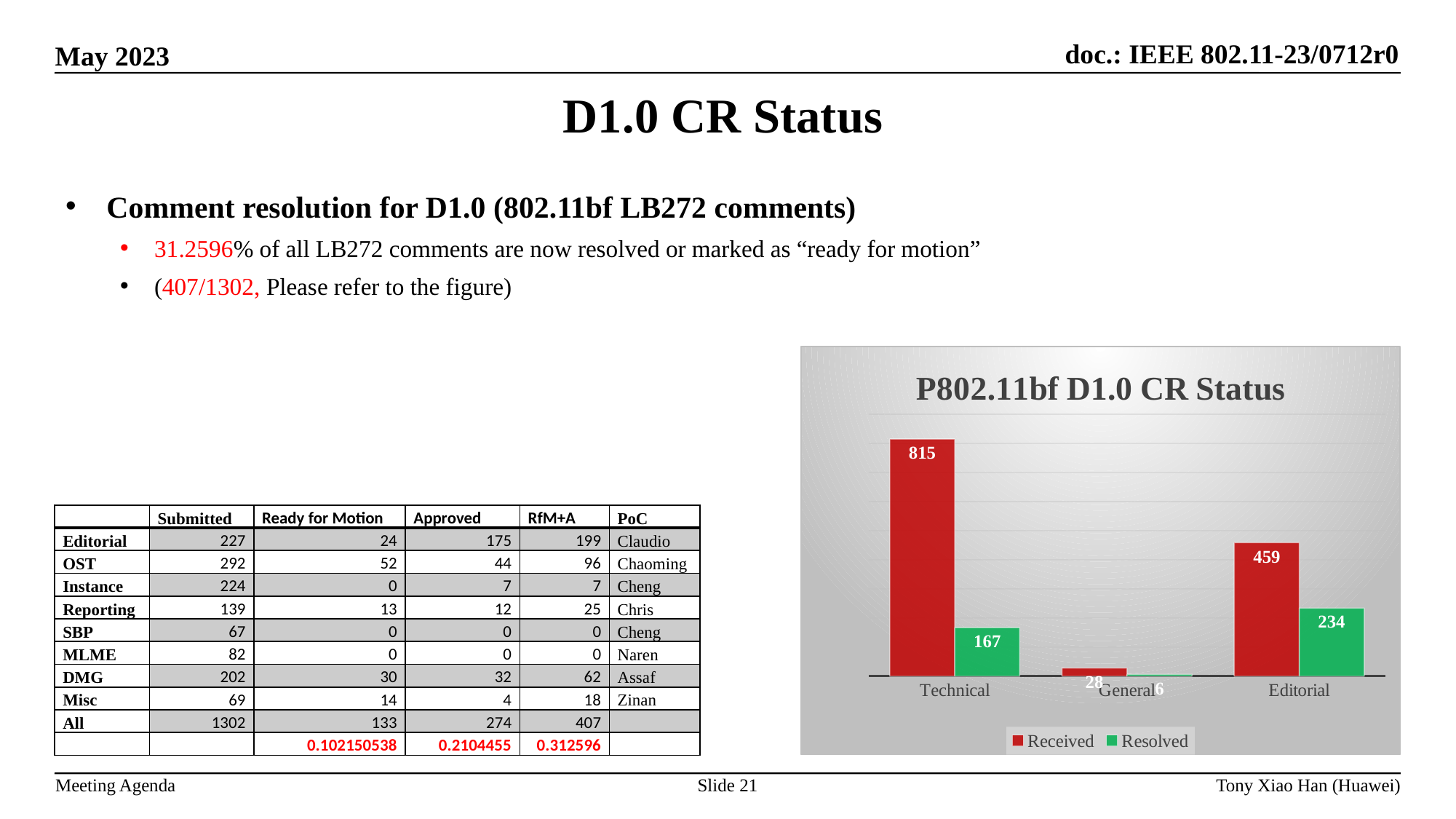
Which is larger, the Resolved value for Editorial or the Resolved value for Technical? Editorial How many series does the chart legend list? 2 How many categories are shown on the x axis of the chart? 3 What type of chart is shown on the slide? bar chart Which category has the highest Received value? Technical What is the Resolved value for Editorial? 234 What is the difference between the Received and Resolved values for Technical? 648 What is the Resolved value for Technical? 167 What is the Received value for Editorial? 459 What is the title of the chart? P802.11bf D1.0 CR Status Which category has the lowest Resolved value? General What is the Received value for Technical? 815